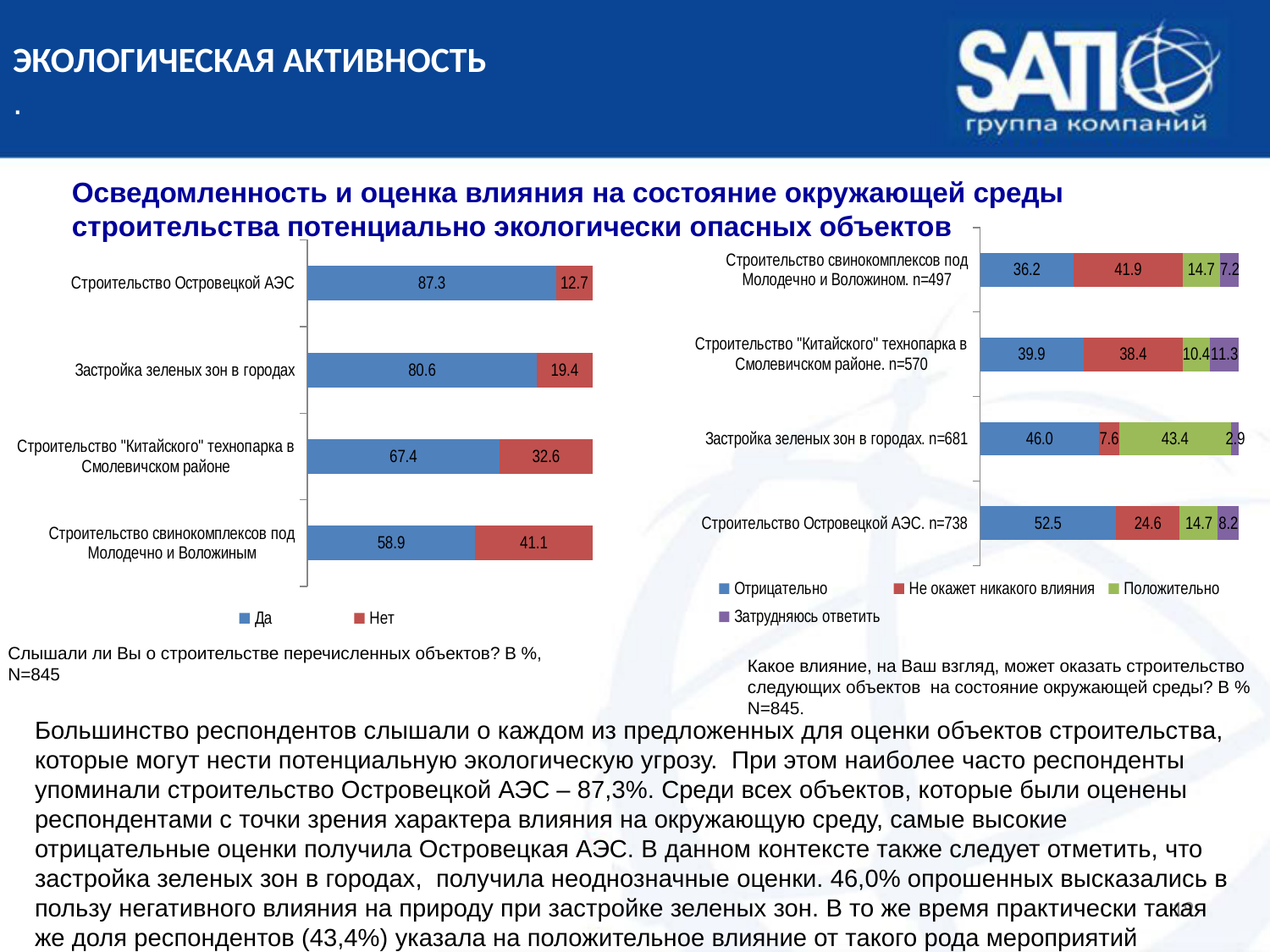
How many series does the legend of the right chart list? 4 In the right chart, which category has the highest 'Отрицательно' value? Строительство Островецкой АЭС. n=738 In the left chart, what is the 'Нет' value for Строительство свинокомплексов под Молодечно и Воложиным? 41.1 In the left chart, what is the difference between the 'Да' values for Застройка зеленых зон в городах and Строительство "Китайского" технопарка в Смолевичском районе? 13.2 How many categories are shown in the right chart? 4 In the left chart, which category has the lowest 'Да' value? Строительство свинокомплексов под Молодечно и Воложиным In the right chart, what is the 'Отрицательно' value for Строительство Островецкой АЭС. n=738? 52.5 In the right chart, which is larger for Строительство свинокомплексов под Молодечно и Воложином. n=497: 'Отрицательно' or 'Не окажет никакого влияния'? Не окажет никакого влияния What type of chart is the right chart? bar chart In the right chart, what is the 'Положительно' value for Застройка зеленых зон в городах. n=681? 43.4 In the left chart, what is the 'Да' value for Строительство Островецкой АЭС? 87.3 How many series does the legend of the left chart list? 2